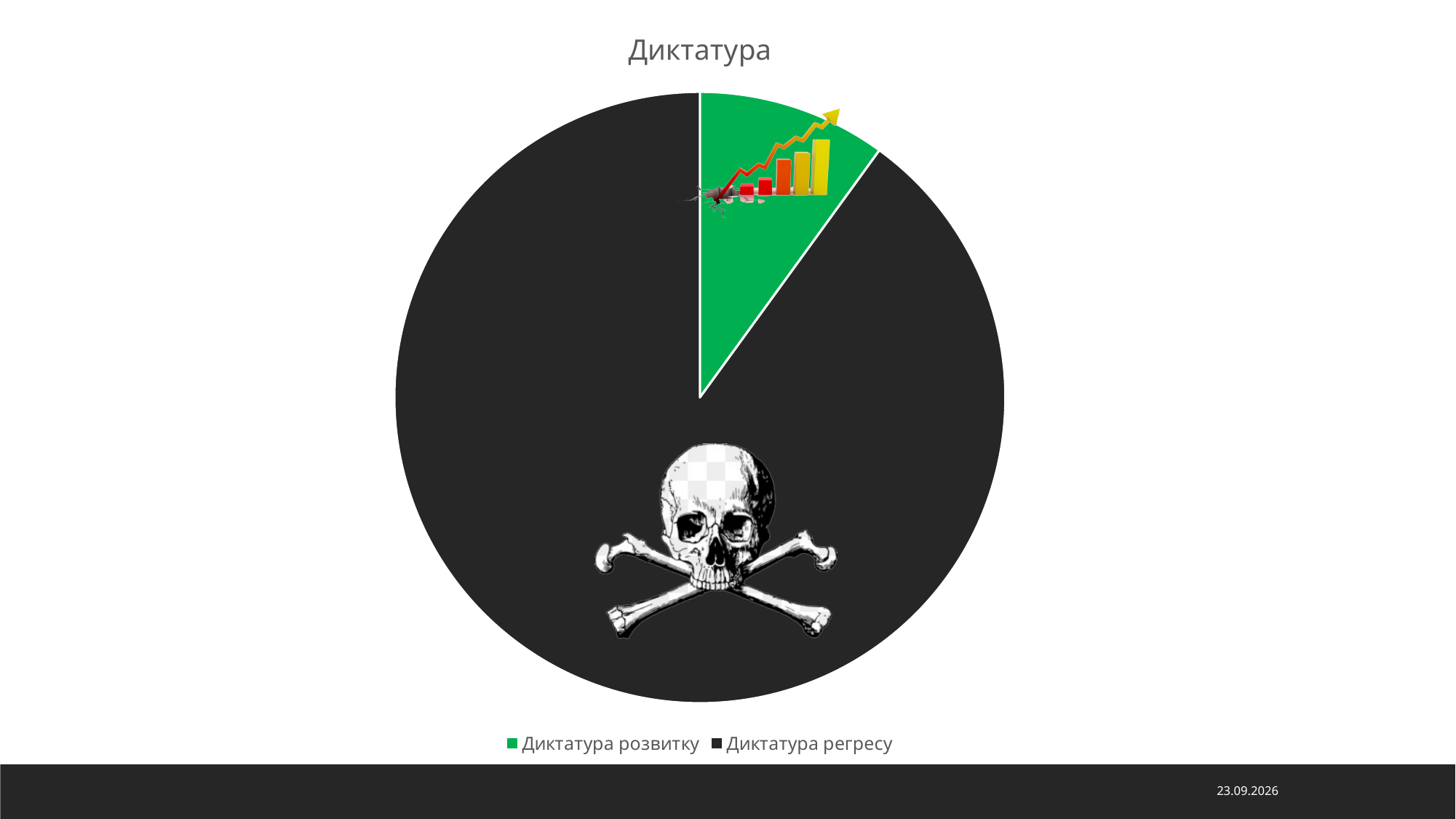
What kind of chart is shown on the slide? pie chart Which legend entry is listed first? Диктатура розвитку Which slice is larger, Диктатура розвитку or Диктатура регресу? Диктатура регресу How many slices does the pie chart have? 2 What colour is the slice for Диктатура розвитку? green What is the title of the chart? Диктатура Which category has the largest slice of the pie? Диктатура регресу Which category is shown in black on the pie chart? Диктатура регресу Which category has the smallest slice of the pie? Диктатура розвитку How many entries does the legend list? 2